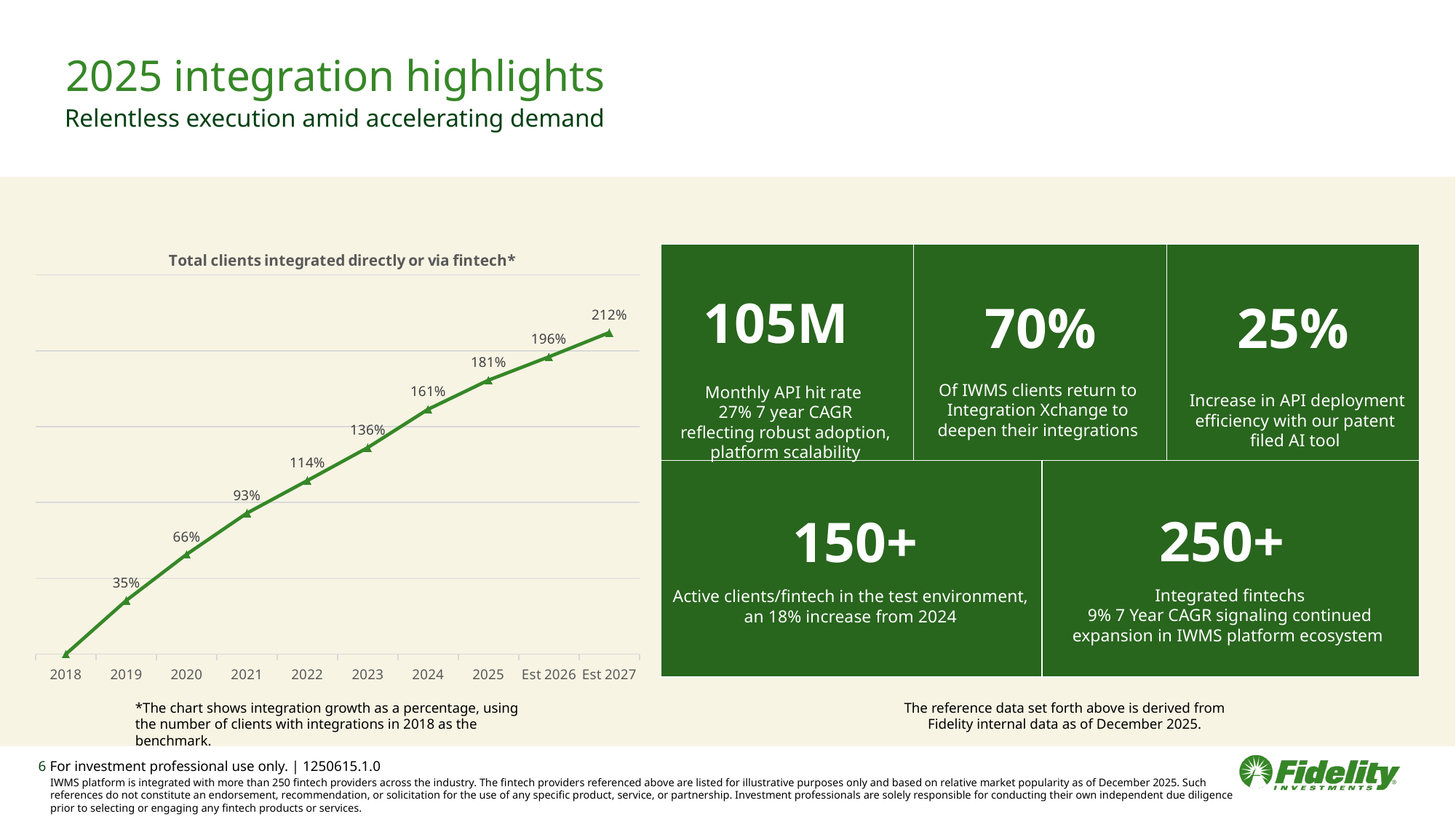
What kind of chart is shown on the slide? Line chart What is the value for Est 2027 in the chart? 212% Do the values rise or fall from 2018 to Est 2027? Rise What is the difference between the values for 2025 and 2024? 20% What is the value for 2021 in the chart? 93% How many years are plotted on the x axis of the chart? 10 What is the value for 2019 in the chart? 35% Which year has the lowest value in the chart? 2018 What is the value for 2024 in the chart? 161% What is the difference between the values for 2023 and 2020? 70% Which year has the highest value in the chart? Est 2027 Which is larger, the value for 2022 or the value for 2021? 2022